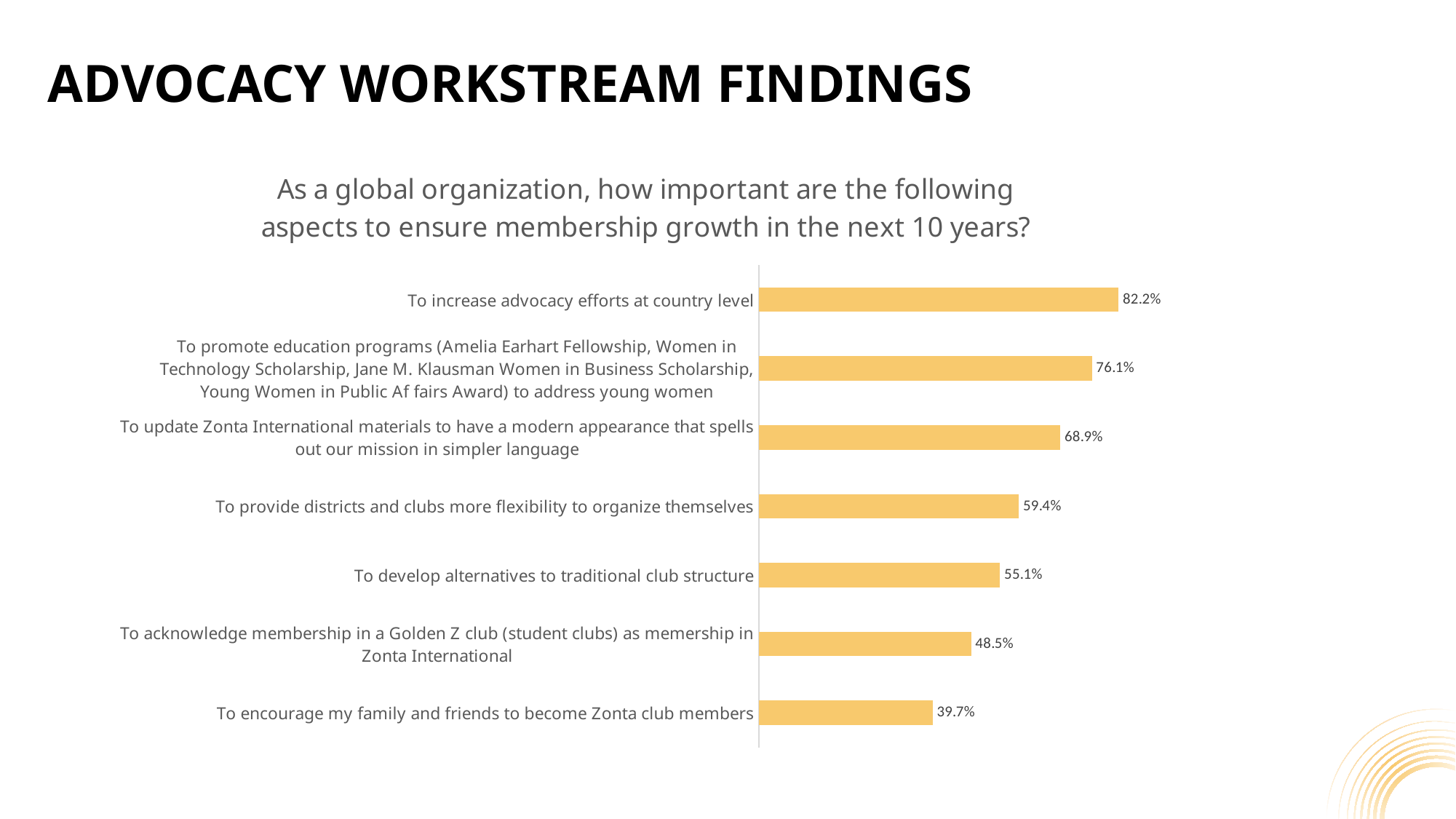
What kind of chart is shown on the slide? Bar chart How many categories are shown in the chart? 7 Which category has the highest value? To increase advocacy efforts at country level Which is larger: the value for "To develop alternatives to traditional club structure" or the value for "To acknowledge membership in a Golden Z club (student clubs) as memership in Zonta International"? To develop alternatives to traditional club structure What is the value for "To encourage my family and friends to become Zonta club members"? 39.7% What is the value for "To increase advocacy efforts at country level"? 82.2% What is the difference between the values for "To increase advocacy efforts at country level" and "To encourage my family and friends to become Zonta club members"? 42.5% What question does the chart title ask? As a global organization, how important are the following aspects to ensure membership growth in the next 10 years? What is the value for "To provide districts and clubs more flexibility to organize themselves"? 59.4% What is the value for "To develop alternatives to traditional club structure"? 55.1% Which category has the lowest value? To encourage my family and friends to become Zonta club members What is the difference between the values for "To update Zonta International materials to have a modern appearance that spells out our mission in simpler language" and "To provide districts and clubs more flexibility to organize themselves"? 9.5%